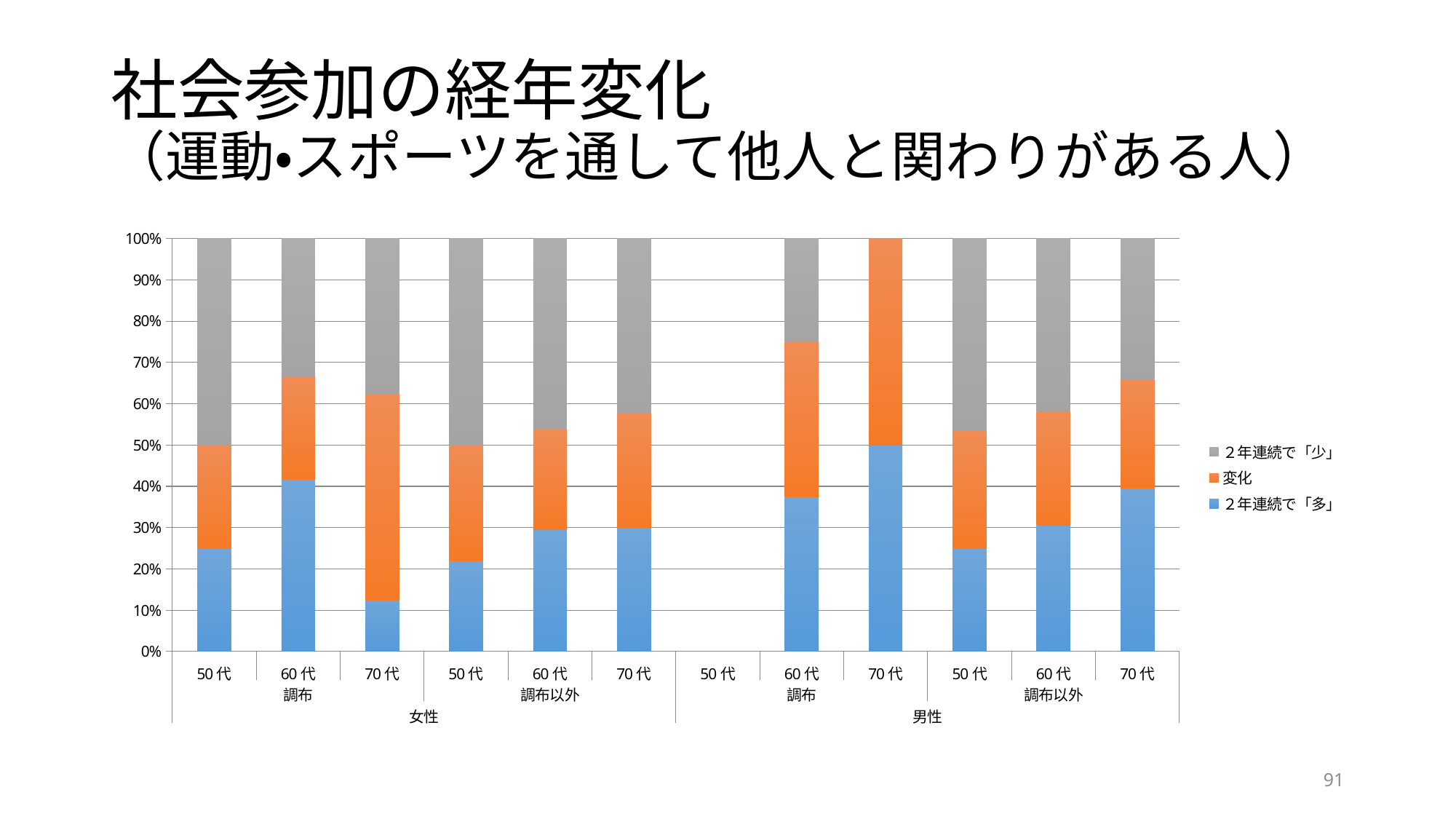
Is the 2年連続で「多」 value for 女性 調布以外 50代 greater or less than 20%? greater Which category has the largest 2年連続で「多」 segment? 男性 調布 70代 How many age-group categories are labelled along the x axis? 12 Is the 2年連続で「多」 value for 男性 調布 60代 greater or less than 40%? less What kind of chart is shown on the slide? stacked bar chart Which colour represents the 変化 series? orange Which has the larger 2年連続で「多」 segment, 女性 調布 50代 or 女性 調布 60代? 女性 調布 60代 How many series does the legend list? 3 What is the value of 2年連続で「多」 for 男性 調布 70代? 50% Which category has no bar plotted? 男性 調布 50代 What are the three series listed in the legend? 2年連続で「少」, 変化, 2年連続で「多」 Which category has the smallest 2年連続で「多」 segment? 女性 調布 70代